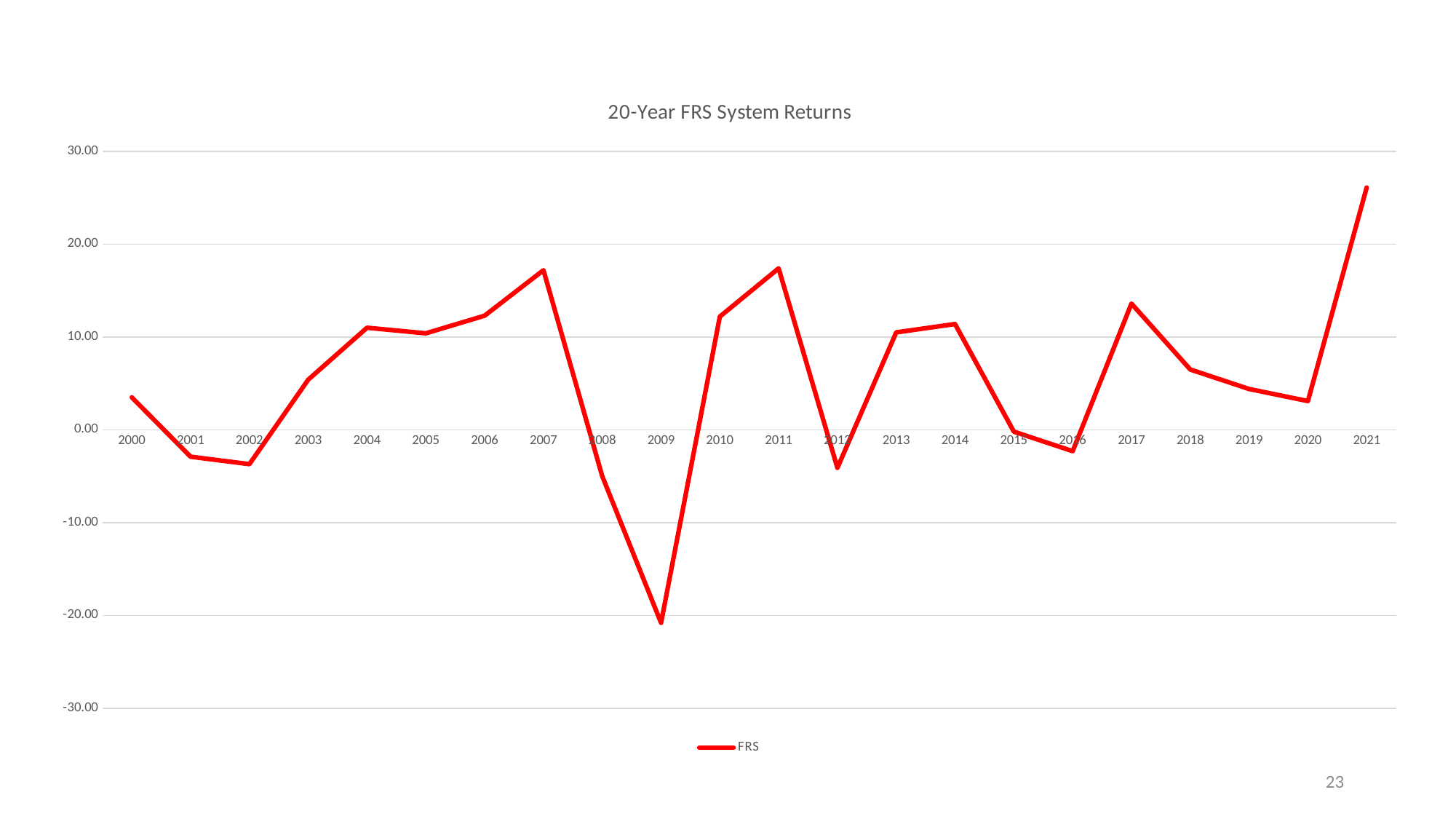
Which year has the highest FRS return? 2021 Is the value for 2009 greater or less than -10.00? less What is the title of the chart? 20-Year FRS System Returns How many series does the legend list? 1 Which year has the lowest FRS return? 2009 Is the value for 2021 greater or less than 20.00? greater Is the value for 2018 greater or less than 10.00? less What kind of chart is shown on the slide? Line chart Which year has the larger FRS return, 2007 or 2008? 2007 How many years are plotted along the x axis? 22 Do the FRS returns rise or fall from 2002 to 2007? rise